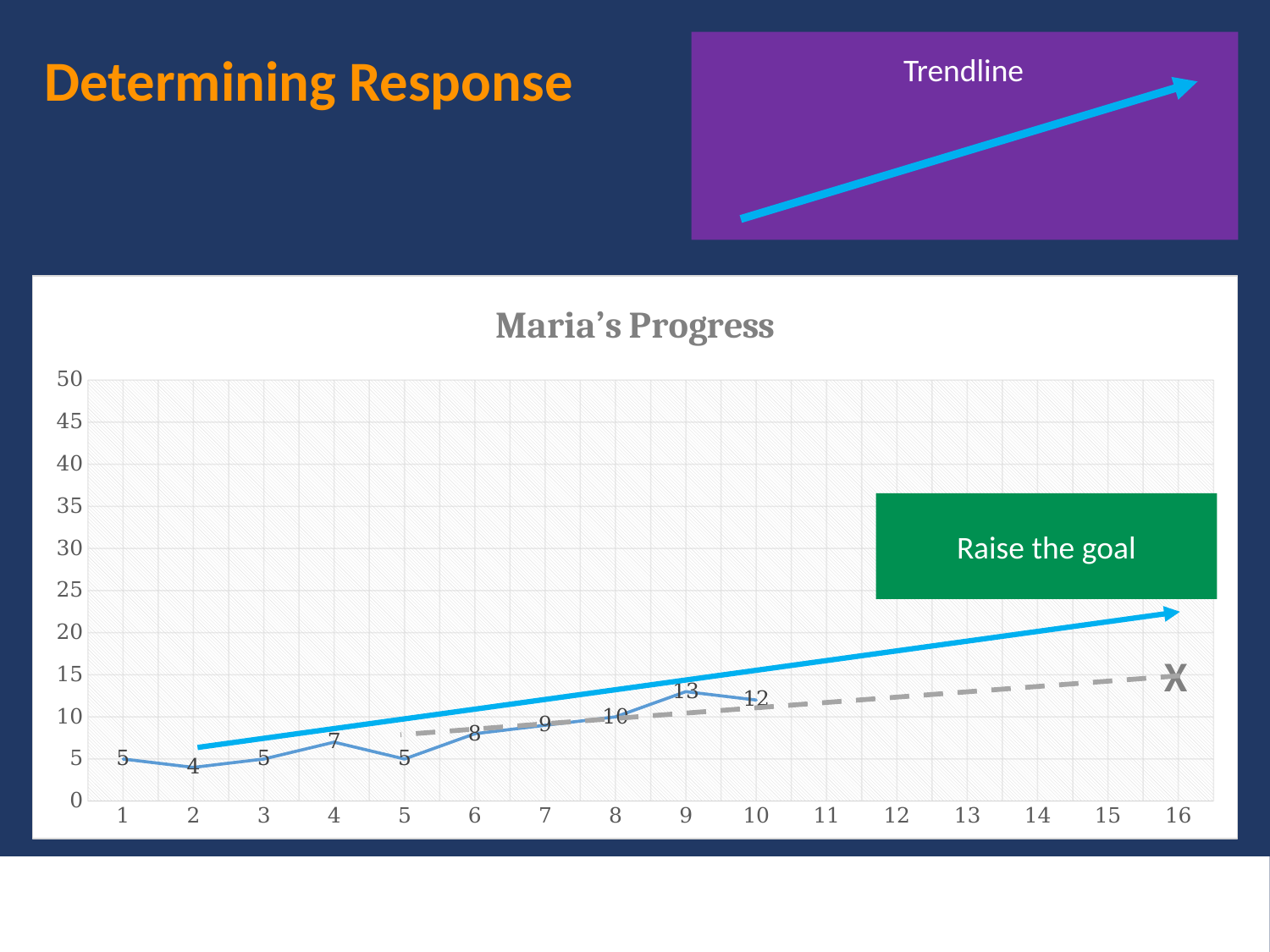
What is the value at point 2 in Maria's Progress? 4 Which is larger, the value at point 4 or the value at point 5? point 4 How many data points are plotted on the line in Maria's Progress? 10 What is the value at point 9 in Maria's Progress? 13 What type of chart is shown on the slide? line chart Do the plotted values generally rise or fall from point 1 to point 10? rise At which point is Maria's Progress lowest? 2 What is the difference between the values at point 9 and point 1? 8 Is the value at point 8 greater or less than 15? less At which point is Maria's Progress highest? 9 What is the title of the chart? Maria's Progress What is the value at point 10 in Maria's Progress? 12